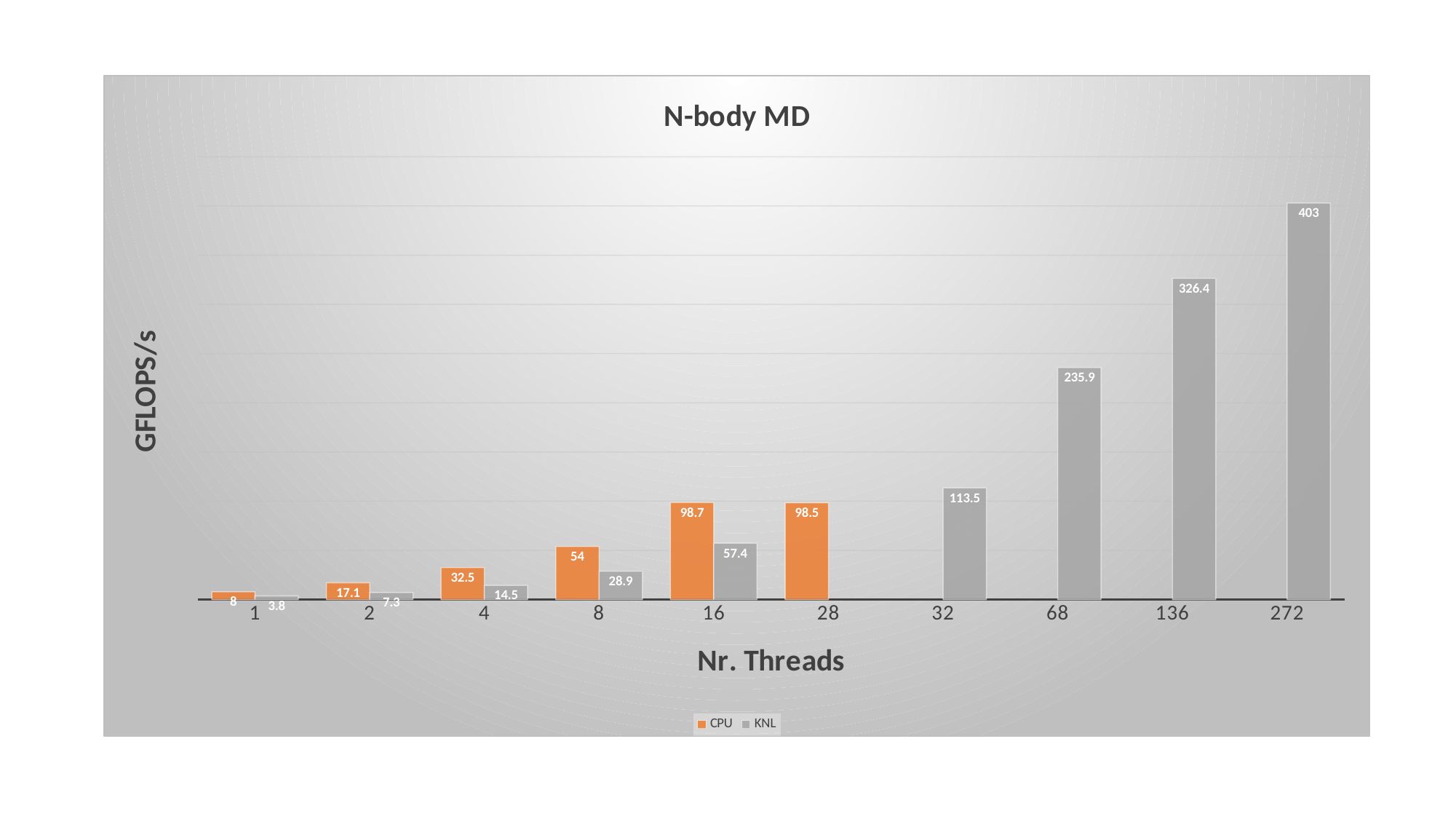
What is the CPU value at 4 threads? 32.5 What kind of chart is shown? Bar chart At which number of threads is the KNL value highest? 272 Which is larger at 8 threads, the CPU value or the KNL value? CPU At which number of threads is the CPU value lowest? 1 What is the difference between the CPU and KNL values at 16 threads? 41.3 What is the title of the chart? N-body MD What is the difference between the KNL values at 136 and 68 threads? 90.5 How many series does the legend list? 2 What is the CPU value at 16 threads? 98.7 What is the KNL value at 272 threads? 403 What is the KNL value at 8 threads? 28.9